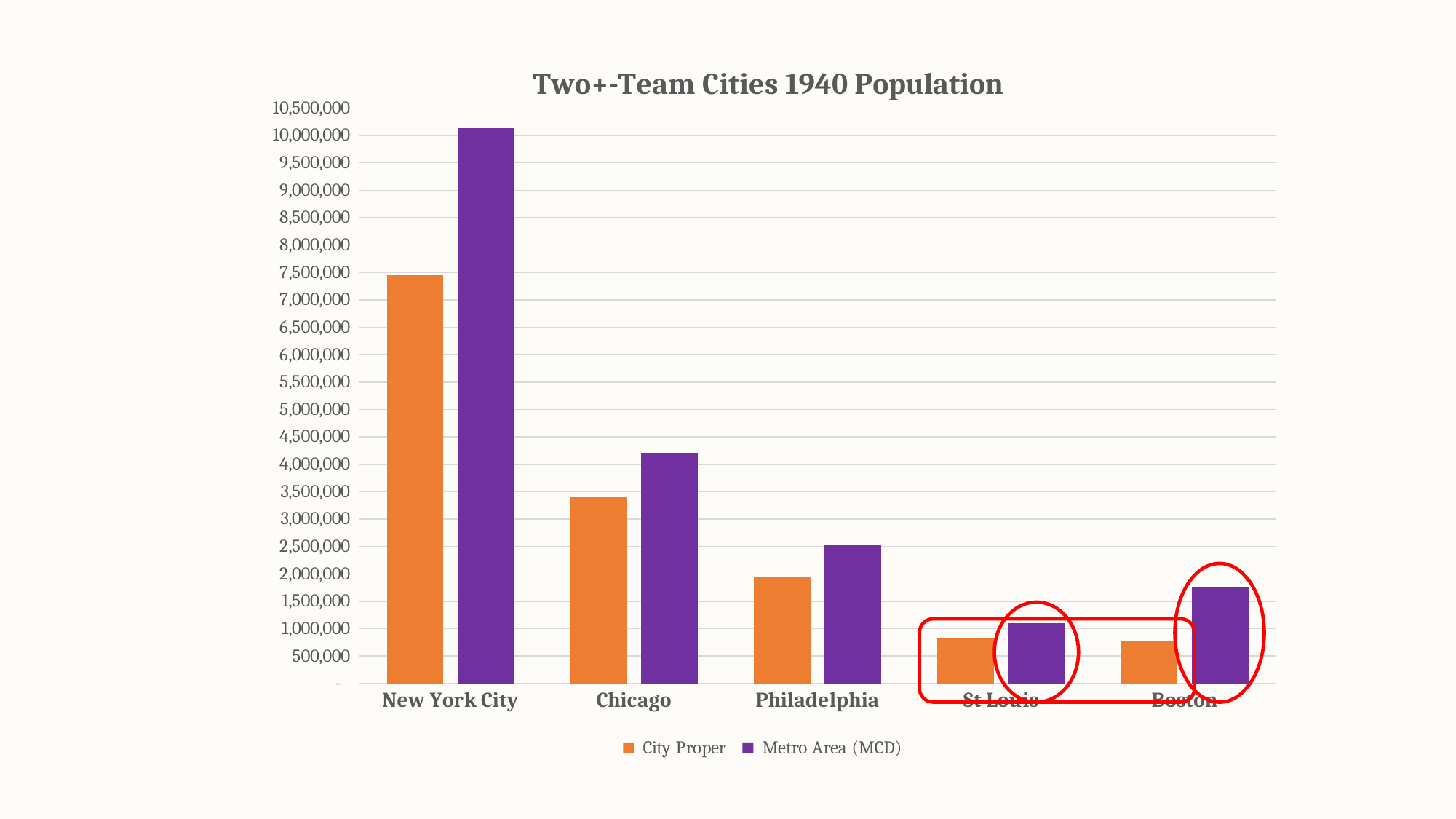
Which city has the lowest Metro Area (MCD) population? St Louis How many series does the legend list? 2 Is the Metro Area (MCD) value for New York City greater or less than 9,500,000? greater How many cities are shown on the x axis of the chart? 5 What is the title of the chart? Two+-Team Cities 1940 Population Which is larger: the Metro Area (MCD) value for Boston or the Metro Area (MCD) value for St Louis? Boston Do the City Proper values rise or fall from New York City to Boston along the x axis? fall Is the Metro Area (MCD) value for Boston greater or less than 1,500,000? greater Is the City Proper value for Chicago greater or less than 3,500,000? less Which city has the highest Metro Area (MCD) population? New York City What kind of chart is shown on the slide? bar chart